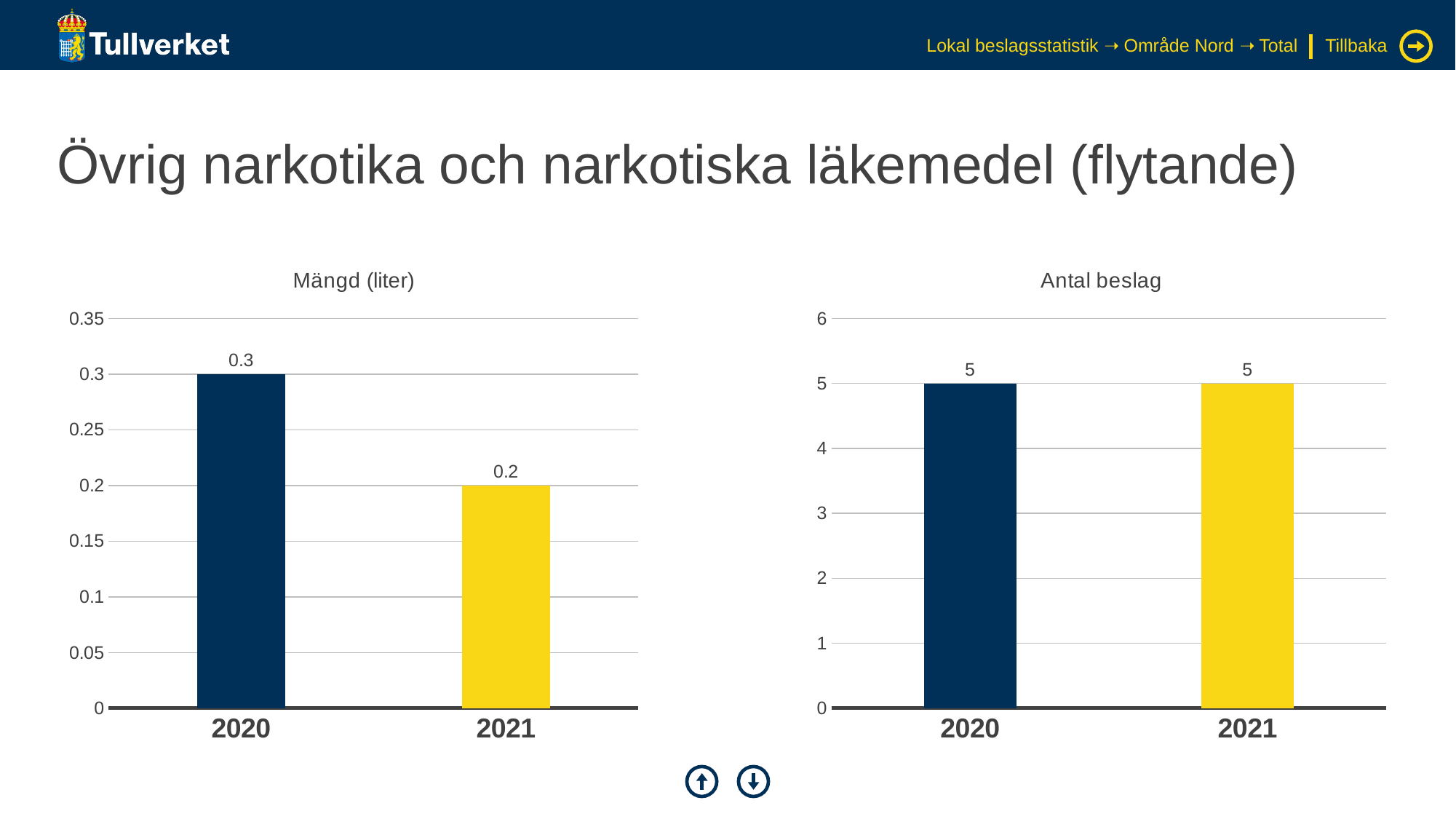
In the 'Mängd (liter)' chart, what is the value for 2021? 0.2 How many years are shown in the 'Antal beslag' chart? 2 In the 'Antal beslag' chart, what is the value for 2021? 5 In the 'Mängd (liter)' chart, is the value for 2021 greater or less than 0.25? less In the 'Antal beslag' chart, what is the difference between the 2020 and 2021 values? 0 In the 'Mängd (liter)' chart, what is the value for 2020? 0.3 What kind of chart is the 'Mängd (liter)' chart? bar chart In the 'Mängd (liter)' chart, do the values rise or fall from 2020 to 2021? fall In the 'Mängd (liter)' chart, what is the difference between the 2020 and 2021 values? 0.1 In the 'Mängd (liter)' chart, which year has the lowest value? 2021 In the 'Antal beslag' chart, what is the value for 2020? 5 In the 'Mängd (liter)' chart, which year has the highest value? 2020